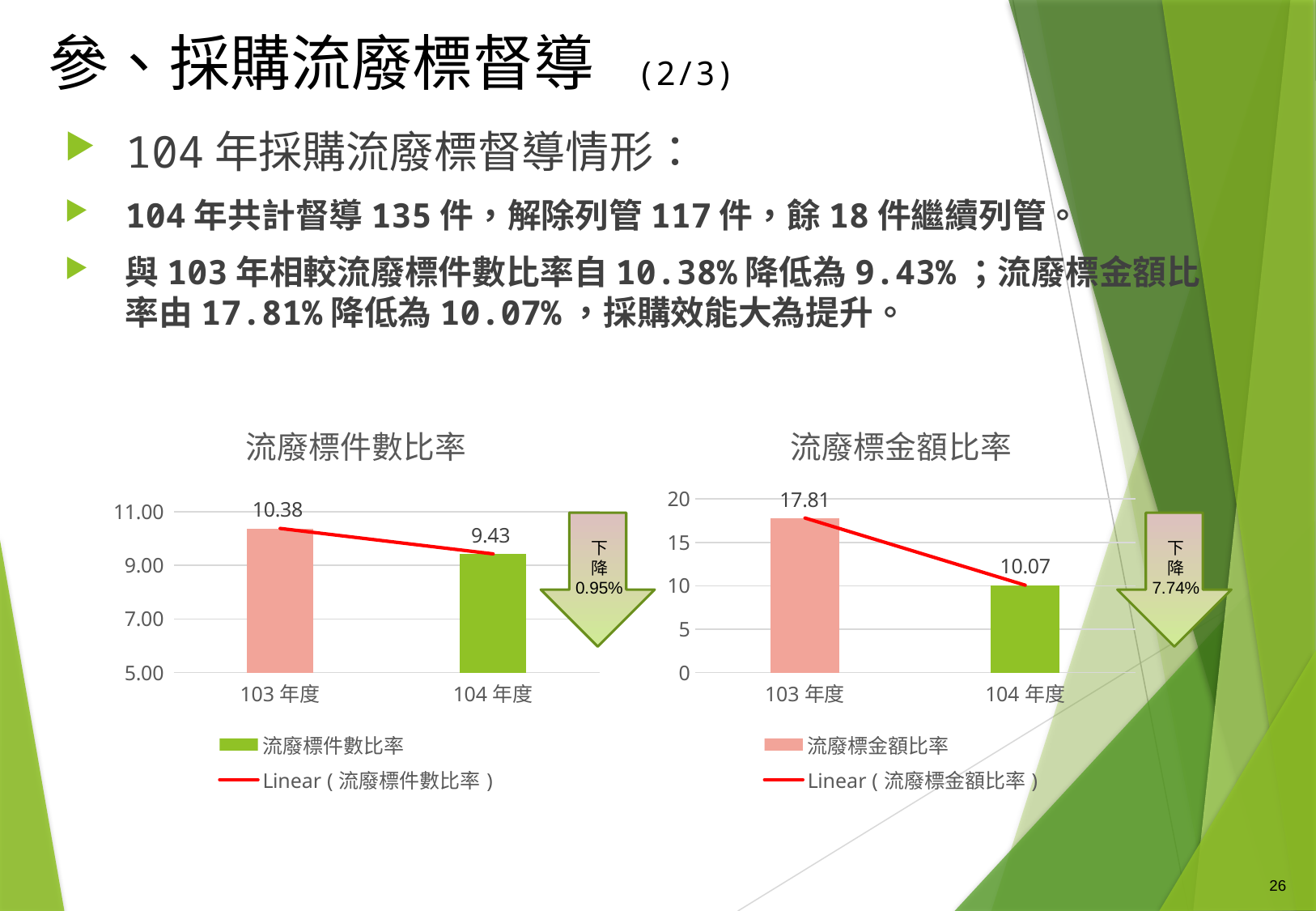
In the chart titled 流廢標金額比率, what is the value for 103 年度? 17.81 In the chart titled 流廢標金額比率, what is the difference between the 103 年度 and 104 年度 values? 7.74 In the chart titled 流廢標金額比率, what is the value for 104 年度? 10.07 How many entries does the legend of the chart titled 流廢標金額比率 list? 2 In the chart titled 流廢標件數比率, what is the value for 104 年度? 9.43 In the chart titled 流廢標金額比率, which year has the higher value? 103 年度 How many categories are shown on the x axis of the chart titled 流廢標件數比率? 2 In the chart titled 流廢標件數比率, which year has the lower value? 104 年度 In the chart titled 流廢標件數比率, do the values rise or fall from 103 年度 to 104 年度? fall In the chart titled 流廢標件數比率, what is the value for 103 年度? 10.38 What kind of chart is the chart titled 流廢標金額比率? bar chart In the chart titled 流廢標件數比率, what is the difference between the 103 年度 and 104 年度 values? 0.95